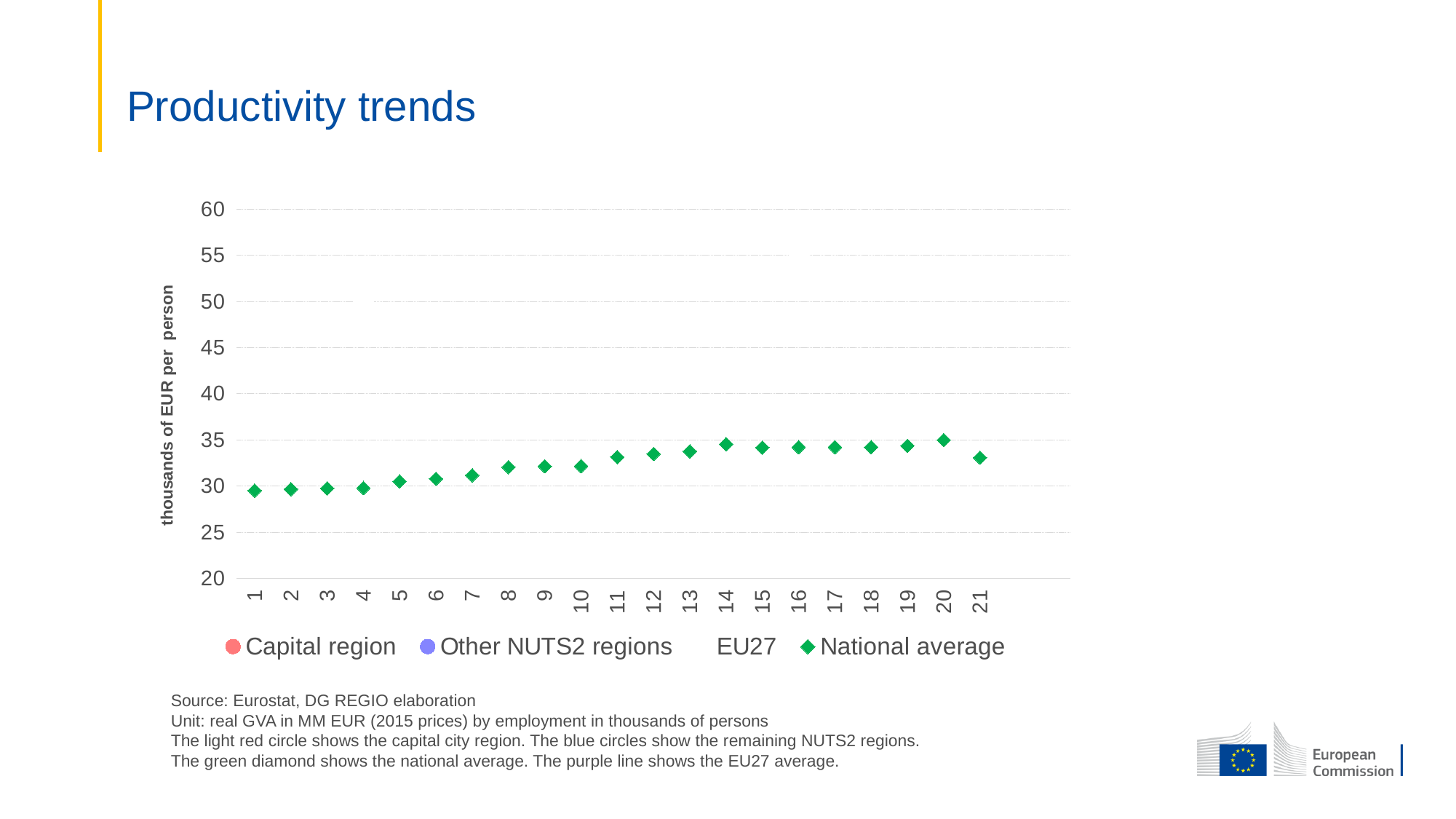
How many points are plotted for the National average series? 21 Which has the larger National average value, x = 1 or x = 21? 21 Is the National average value at x = 14 greater or less than 40? less Is the National average value at x = 8 greater or less than 35? less How many series does the legend list? 4 What is the title of the slide? Productivity trends Do the National average values generally rise or fall from x = 1 to x = 20? rise What kind of chart is shown on the slide? scatter chart Is the National average value at x = 20 greater or less than 30? greater Which has the larger National average value, x = 5 or x = 15? 15 What is the label of the vertical axis? thousands of EUR per person